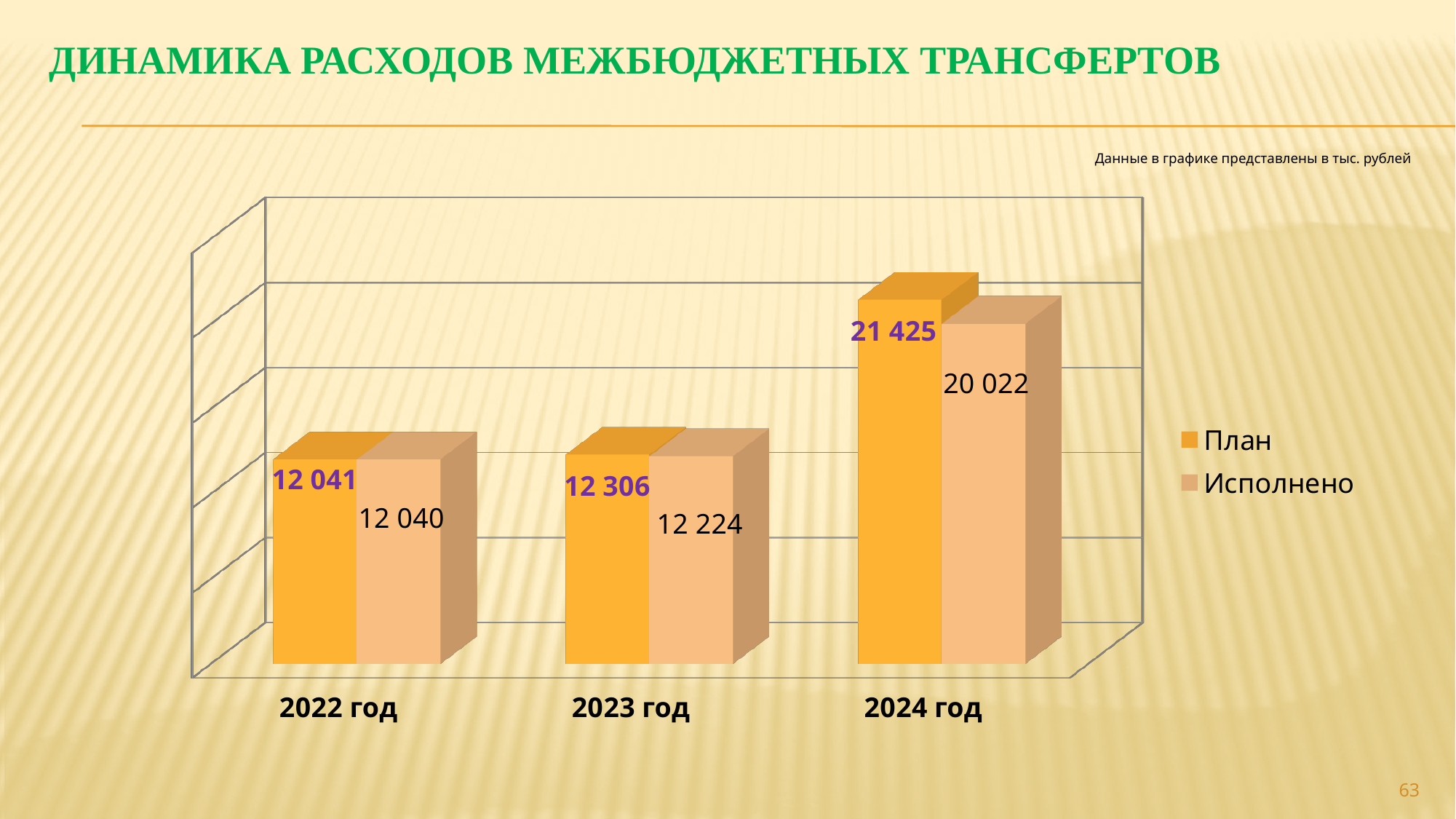
What is the difference between the Исполнено values for 2023 год and 2022 год? 184 What is the Исполнено value for 2023 год? 12 224 What is the План value for 2024 год? 21 425 What kind of chart is shown on the slide? Bar chart How many years are shown on the x axis? 3 Which year has the highest План value? 2024 год What is the План value for 2022 год? 12 041 How many series does the legend list? 2 What is the Исполнено value for 2024 год? 20 022 What is the difference between План and Исполнено for 2024 год? 1 403 Which is larger for 2023 год: План or Исполнено? План Which year has the lowest Исполнено value? 2022 год